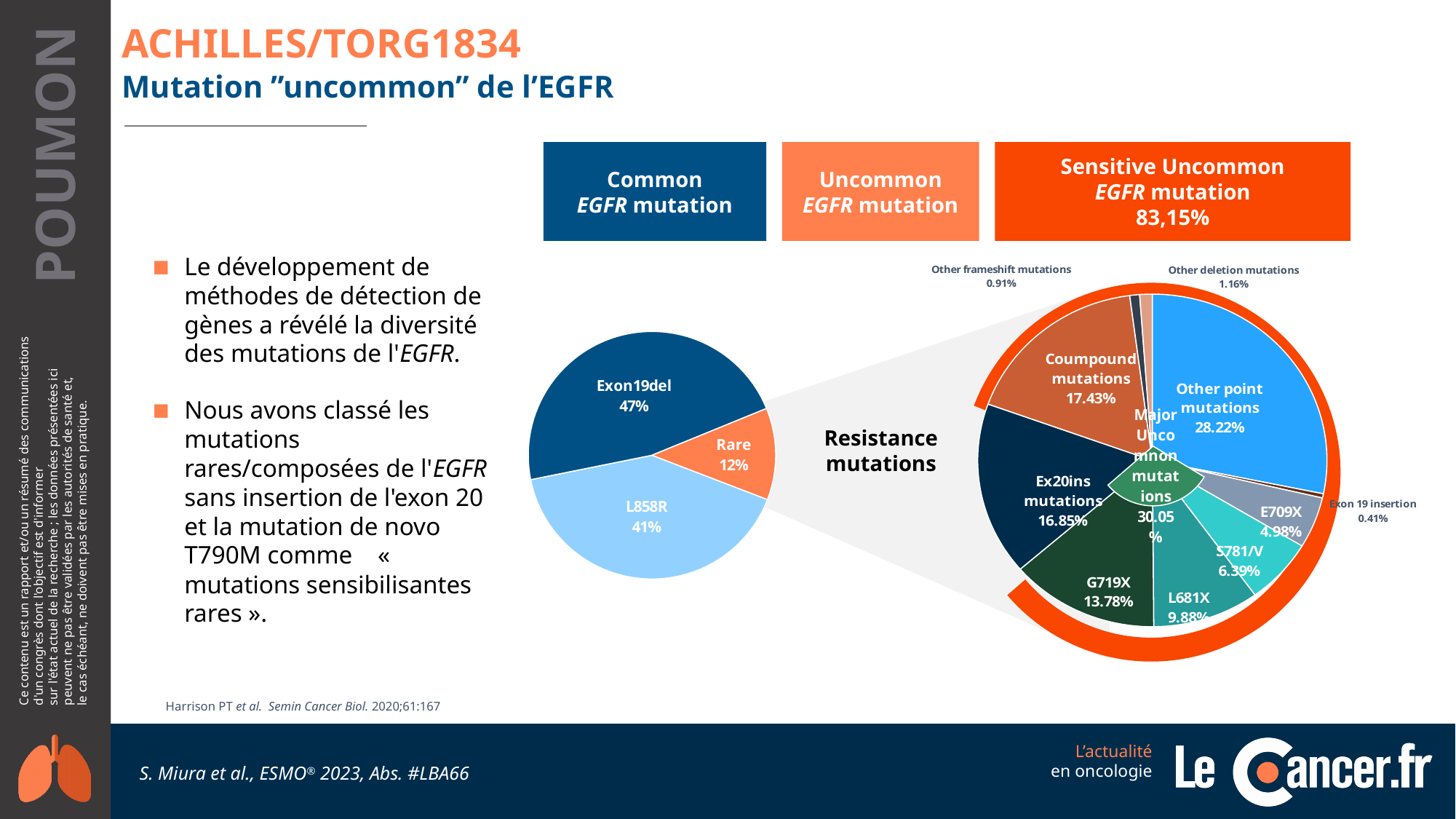
In the left pie chart, what share is labelled for L858R? 41% In the right pie chart, what percentage is labelled for Exon 19 insertion? 0.41% In the left pie chart, what share is labelled for Rare mutations? 12% In the left pie chart, what is the difference between the Exon19del and L858R shares? 6% In the right pie chart, what percentage is labelled for Other point mutations? 28.22% In the left pie chart, which category has the largest slice? Exon19del In the left pie chart, which category has the smallest slice? Rare In the right pie chart, what percentage is labelled for Ex20ins mutations? 16.85% What type of chart is used on the left side of the slide to show Exon19del, L858R and Rare mutations? Pie chart In the right pie chart, which is larger, the share for L681X or the share for S781/V? L681X In the right pie chart, what percentage is labelled for G719X? 13.78% In the left pie chart, what share is labelled for Exon19del? 47%